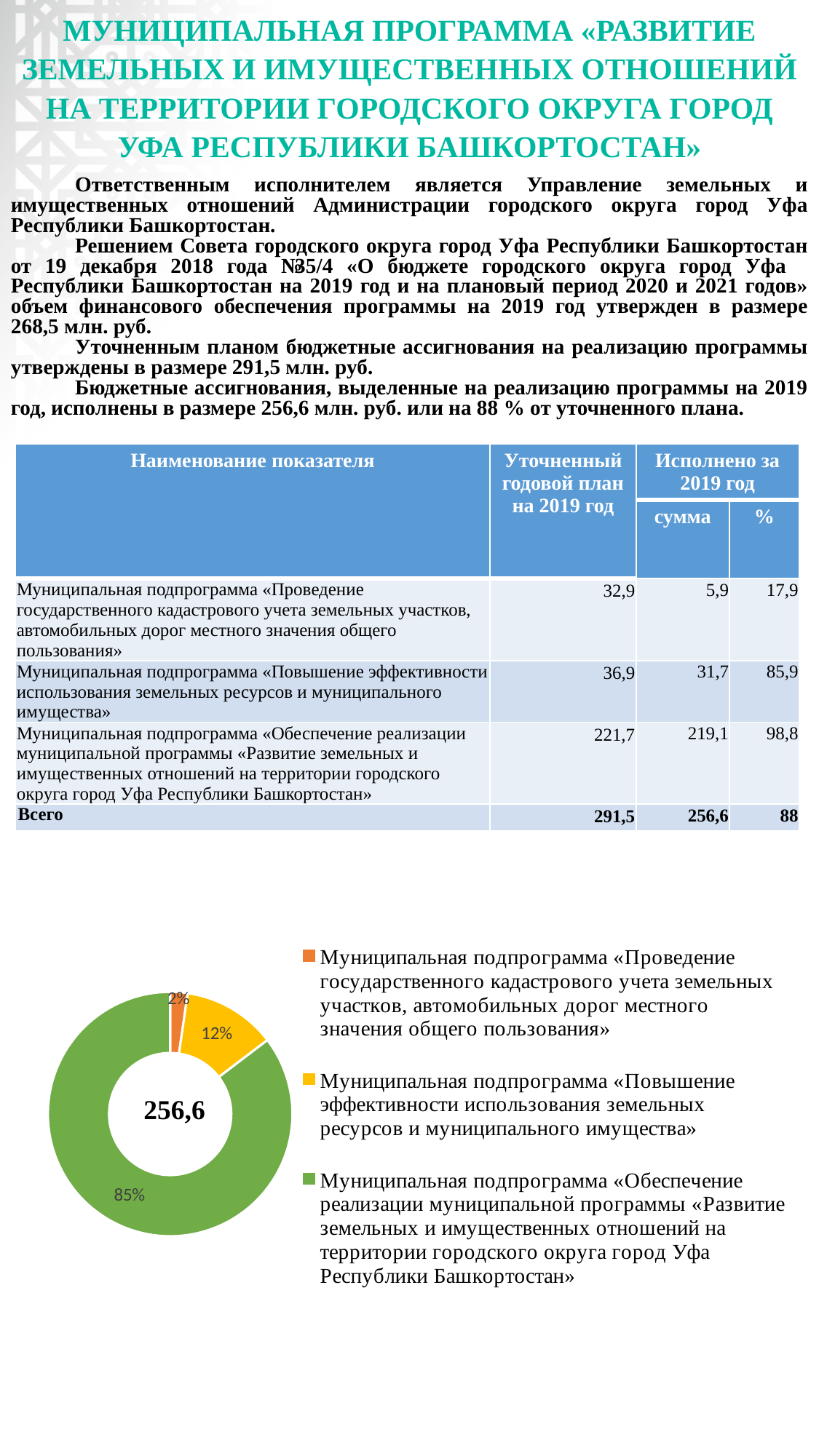
In the doughnut chart, which slice is larger: «Повышение эффективности использования земельных ресурсов и муниципального имущества» or «Проведение государственного кадастрового учета земельных участков, автомобильных дорог местного значения общего пользования»? «Повышение эффективности использования земельных ресурсов и муниципального имущества» What kind of chart is shown at the bottom of the slide? Doughnut (pie) chart Which subprogram has the smallest slice in the doughnut chart? Муниципальная подпрограмма «Проведение государственного кадастрового учета земельных участков, автомобильных дорог местного значения общего пользования» What colour is the largest slice of the doughnut chart? Green What number is printed in the centre of the doughnut chart? 256,6 What share of the doughnut chart is the subprogram «Повышение эффективности использования земельных ресурсов и муниципального имущества»? 12% Which subprogram has the largest slice in the doughnut chart? Муниципальная подпрограмма «Обеспечение реализации муниципальной программы «Развитие земельных и имущественных отношений на территории городского округа город Уфа Республики Башкортостан» What share of the doughnut chart is the subprogram «Проведение государственного кадастрового учета земельных участков, автомобильных дорог местного значения общего пользования»? 2% By how many percentage points does the 85% slice exceed the 12% slice in the doughnut chart? 73 percentage points What share of the doughnut chart is the subprogram «Обеспечение реализации муниципальной программы «Развитие земельных и имущественных отношений на территории городского округа город Уфа Республики Башкортостан»? 85% How many entries does the legend of the doughnut chart list? 3 How many slices does the doughnut chart have? 3